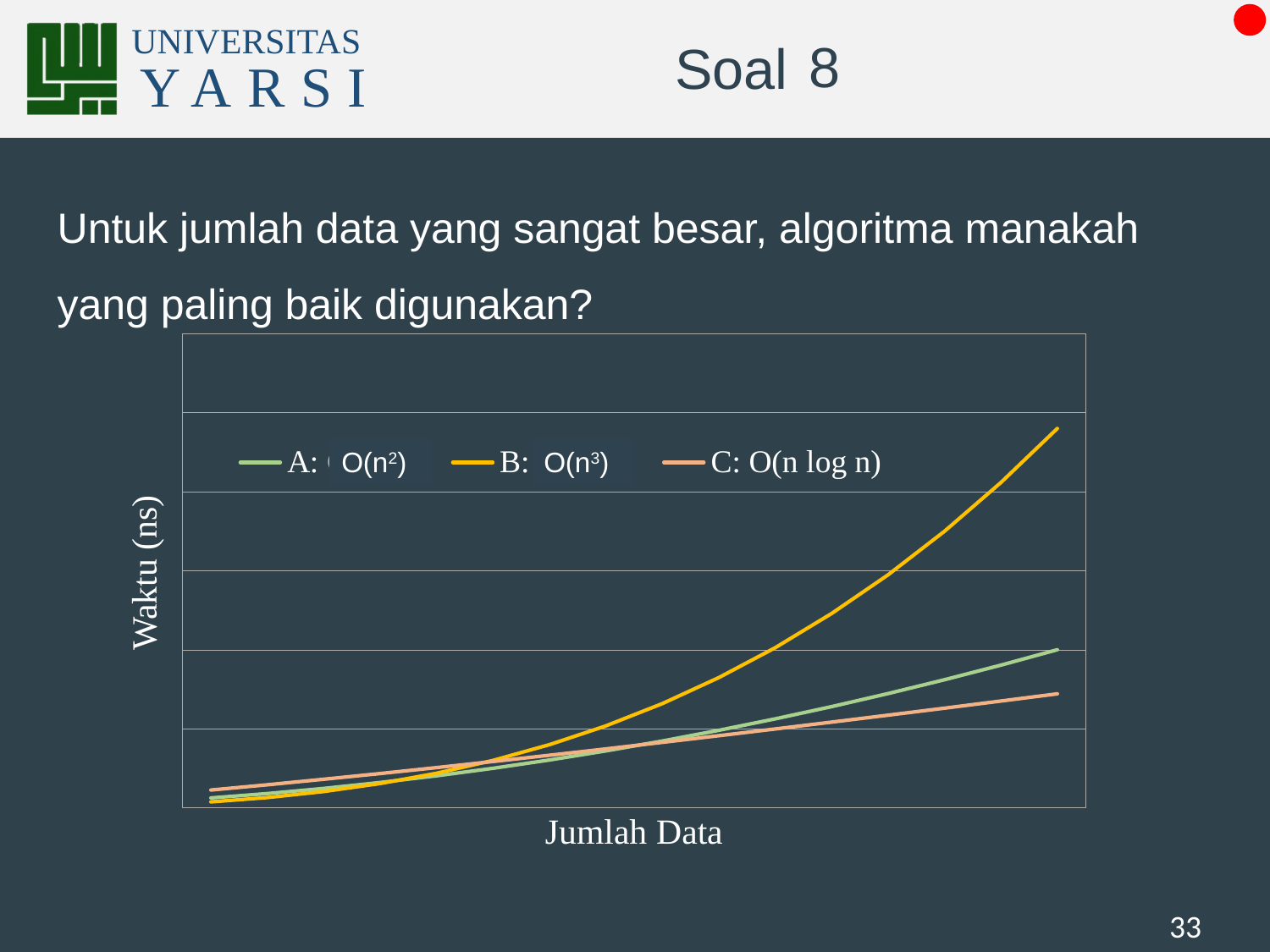
Do the values for C: O(n log n) rise or fall along the x axis? rise What is the label of the chart's vertical axis? Waktu (ns) At the right end of the x axis, which is larger: the value for B: O(n³) or the value for A: O(n²)? B: O(n³) Which series reaches the highest value at the right end of the x axis? B: O(n³) At the right end of the x axis, which is larger: the value for A: O(n²) or the value for C: O(n log n)? A: O(n²) Which series is drawn in yellow? B: O(n³) Which series has the lowest value at the right end of the x axis? C: O(n log n) What kind of chart is shown on the slide? line chart Do the values for B: O(n³) rise or fall as Jumlah Data increases? rise How many series does the chart's legend list? 3 Which series starts with the highest value at the left end of the x axis? C: O(n log n)